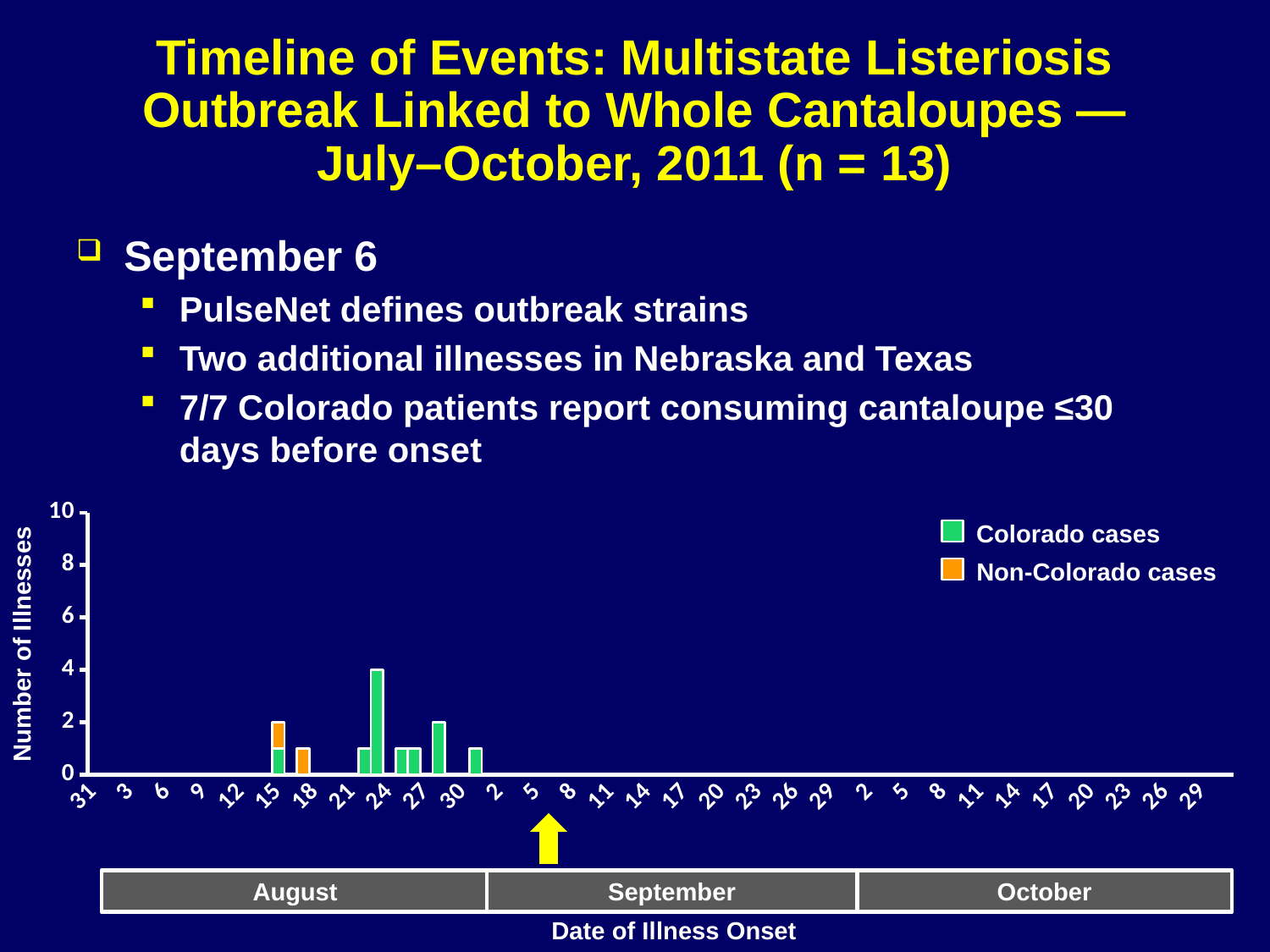
Which series accounts for more of the plotted cases, Colorado cases or Non-Colorado cases? Colorado cases What are the two series named in the chart legend? Colorado cases and Non-Colorado cases In which month do all of the plotted bars fall? August What is the total height of the stacked bar on August 15? 2 What is the height of the tallest bar in the chart? 4 Is the tallest bar in the chart greater or less than 6? less Is the value of the bar on August 31 greater or less than 2? less What kind of chart is shown on the slide? bar chart How many series does the chart legend list? 2 What is the title of the chart's vertical axis? Number of Illnesses How many bars (dates with illnesses) are plotted in the chart? 8 Are there any bars plotted in October? No